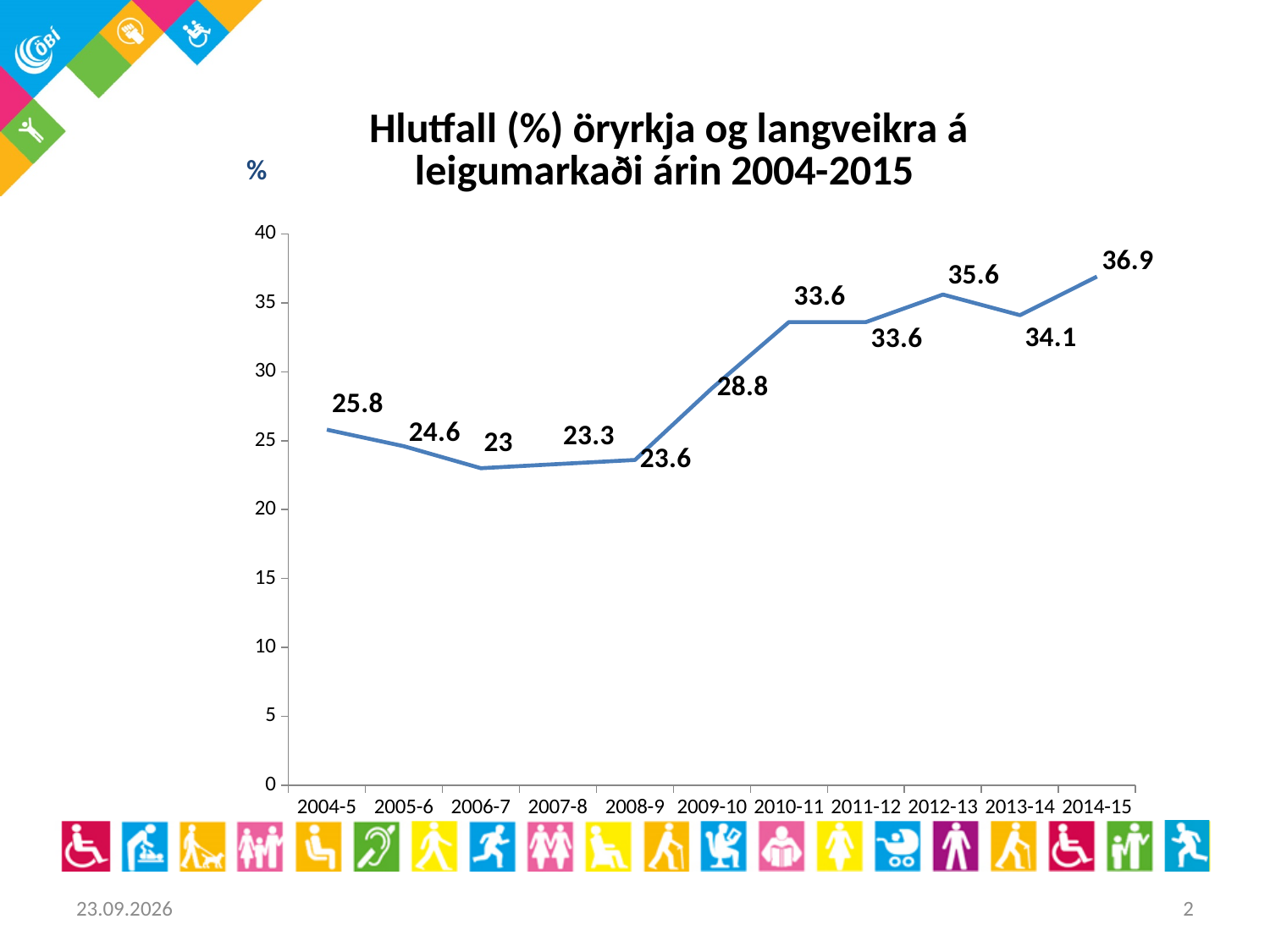
What kind of chart is shown? line chart What is the value for 2012-13? 35.6 Is the value for 2008-9 greater or less than 25? less Do the values generally rise or fall from 2008-9 to 2014-15? rise Which is larger, the value for 2013-14 or the value for 2012-13? 2012-13 Which year has the lowest value? 2006-7 What is the difference between the values for 2014-15 and 2004-5? 11.1 Which year has the highest value? 2014-15 What is the value for 2004-5? 25.8 What is the value for 2009-10? 28.8 What is the difference between the values for 2010-11 and 2009-10? 4.8 How many years are plotted on the x axis? 11